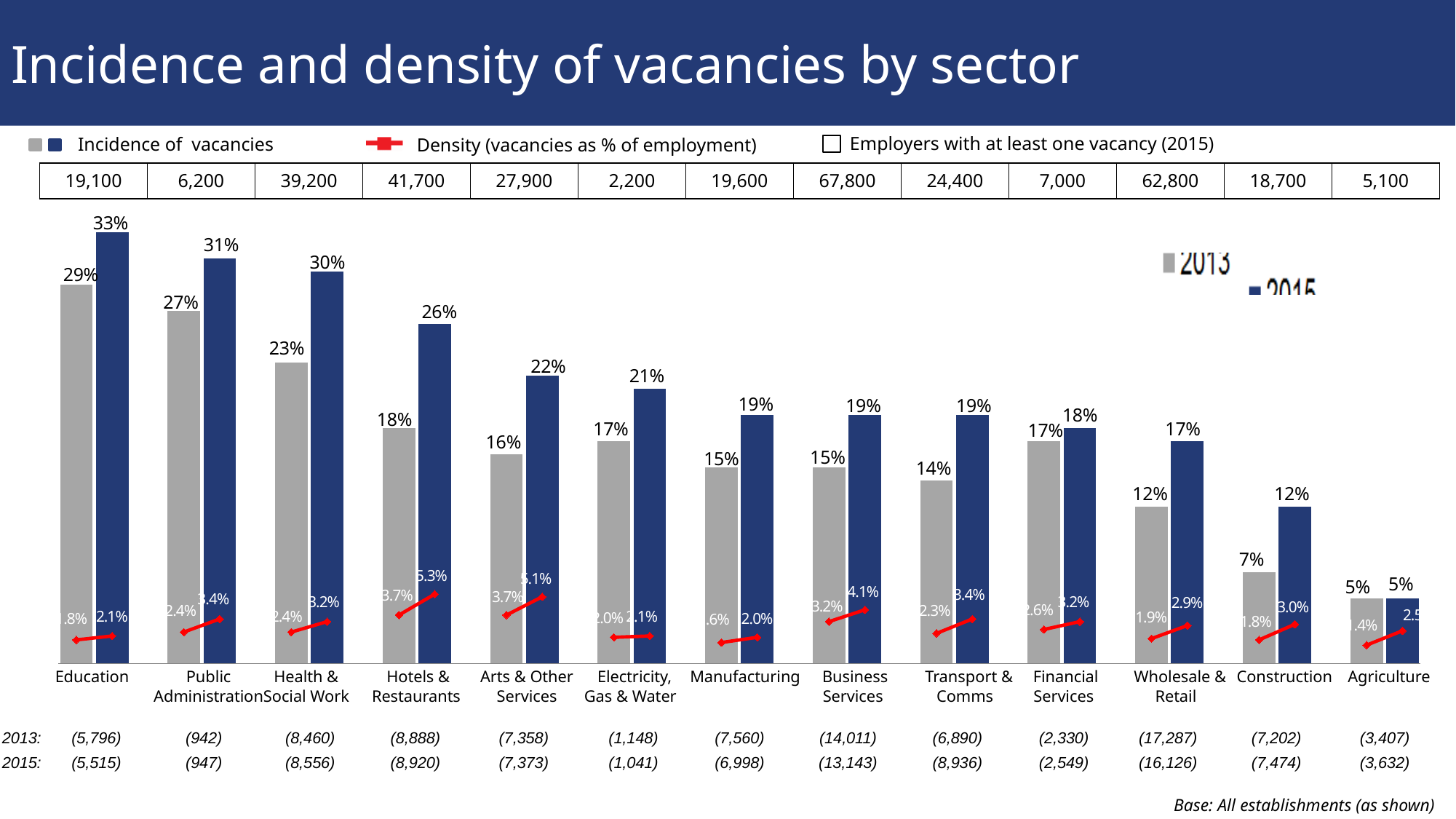
Which sector has the highest incidence of vacancies in 2015? Education How many years does the legend list for the incidence of vacancies bars? 2 What is the incidence of vacancies for Construction in 2013? 7% Which is larger, the 2015 incidence of vacancies for Wholesale & Retail or for Construction? Wholesale & Retail What is the difference between the 2015 and 2013 incidence of vacancies for Health & Social Work? 7 percentage points What is the incidence of vacancies for Education in 2015? 33% What is the density of vacancies for Hotels & Restaurants in 2015? 5.3% Which sector has the lowest incidence of vacancies in 2013? Agriculture What kind of chart is used to show the incidence of vacancies? Bar chart How many sectors are shown on the x axis of the chart? 13 What is the title of the slide? Incidence and density of vacancies by sector How many employers with at least one vacancy (2015) are shown for Business Services? 67,800